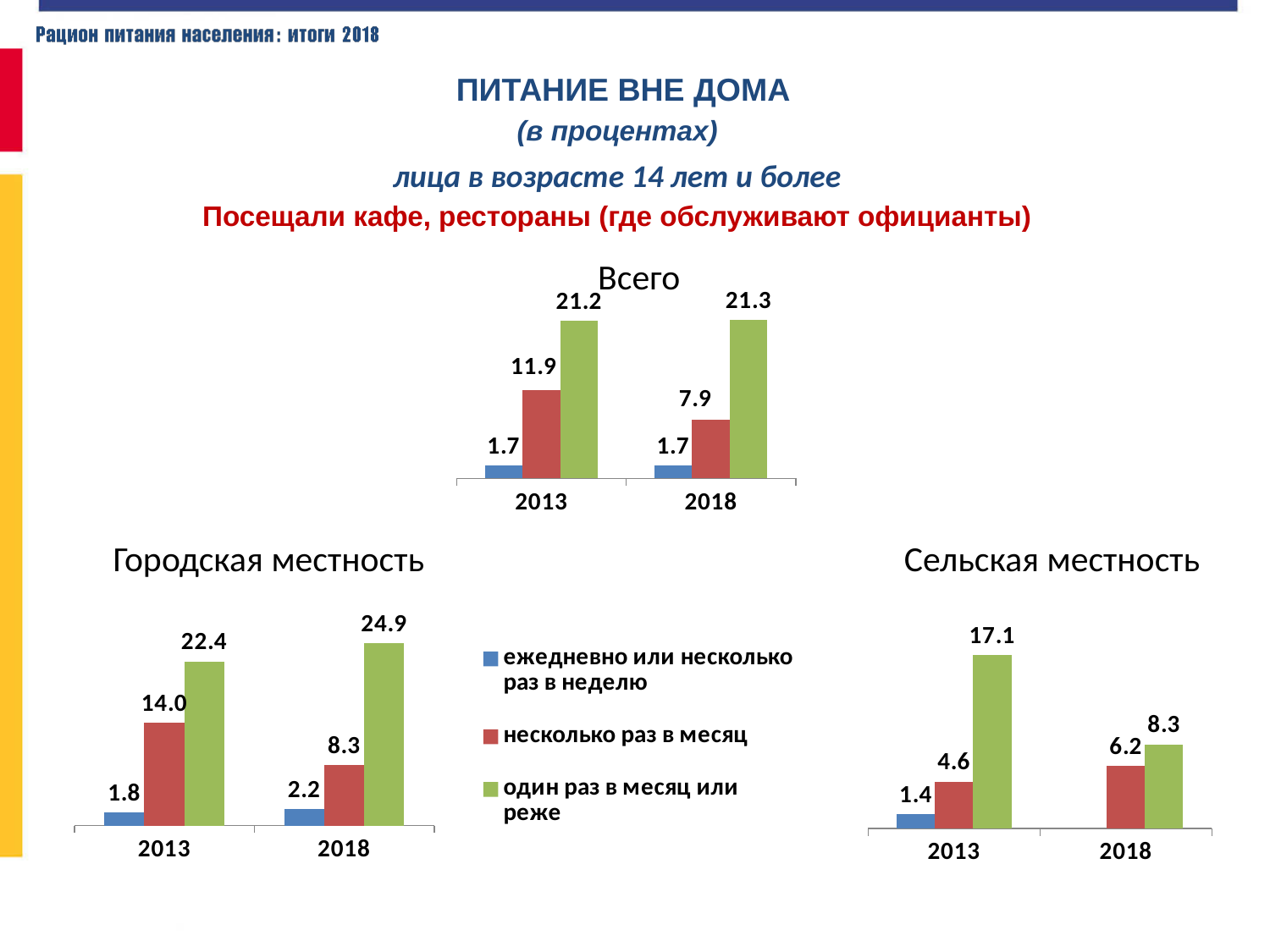
In the 'Сельская местность' chart, what is the value for 'один раз в месяц или реже' in 2013? 17.1 In the 'Городская местность' chart, is the 'один раз в месяц или реже' value larger in 2013 or in 2018? 2018 In the 'Сельская местность' chart, which series has the lowest value in 2013? ежедневно или несколько раз в неделю In the 'Всего' chart, does the value for 'несколько раз в месяц' rise or fall from 2013 to 2018? fall In the 'Сельская местность' chart, what is the difference between the 'один раз в месяц или реже' values for 2013 and 2018? 8.8 In the 'Всего' chart, what is the value for 'один раз в месяц или реже' in 2018? 21.3 In the 'Городская местность' chart, what is the value for 'ежедневно или несколько раз в неделю' in 2018? 2.2 In the 'Городская местность' chart, by how much did the value for 'несколько раз в месяц' change from 2013 to 2018? 5.7 How many series does the legend list? 3 What type of chart is the 'Всего' chart? bar chart In the 'Всего' chart, what is the value for 'несколько раз в месяц' in 2013? 11.9 In the 'Всего' chart, which series has the highest value in 2018? один раз в месяц или реже